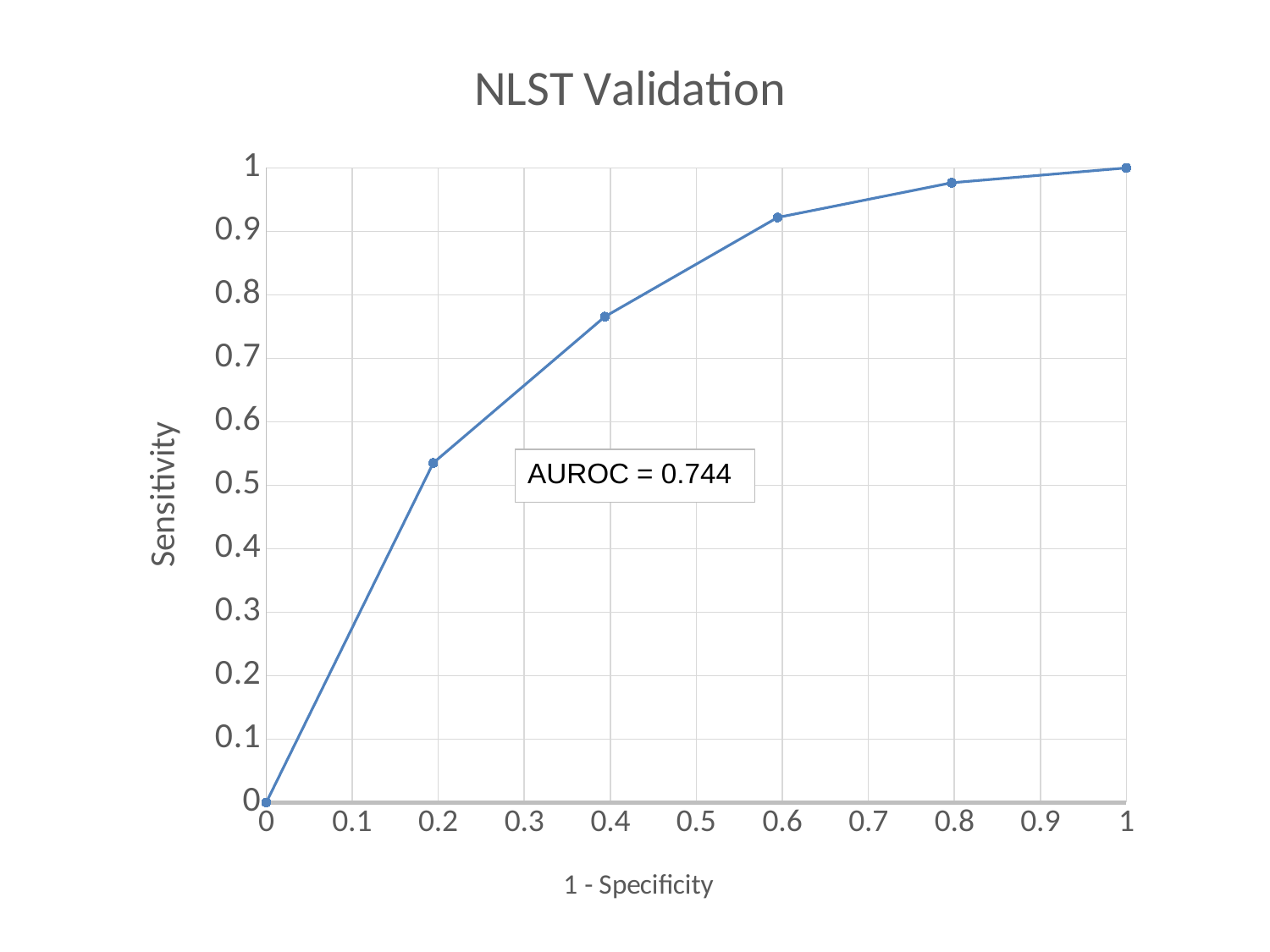
How many data points are plotted on the line? 6 Is the sensitivity at 1 - Specificity of about 0.4 greater or less than 0.7? greater What AUROC value is printed on the chart? 0.744 What is the title of the chart? NLST Validation What kind of chart is shown on the slide? line chart What is the sensitivity at 1 - Specificity = 0? 0 What is the sensitivity at 1 - Specificity = 1? 1 Is the sensitivity at 1 - Specificity of about 0.2 greater or less than 0.6? less Which has the higher sensitivity: the point at 1 - Specificity of about 0.4 or the point at about 0.6? the point at about 0.6 Do the sensitivity values rise or fall as 1 - Specificity increases? rise Is the sensitivity at 1 - Specificity of about 0.6 greater or less than 0.9? greater